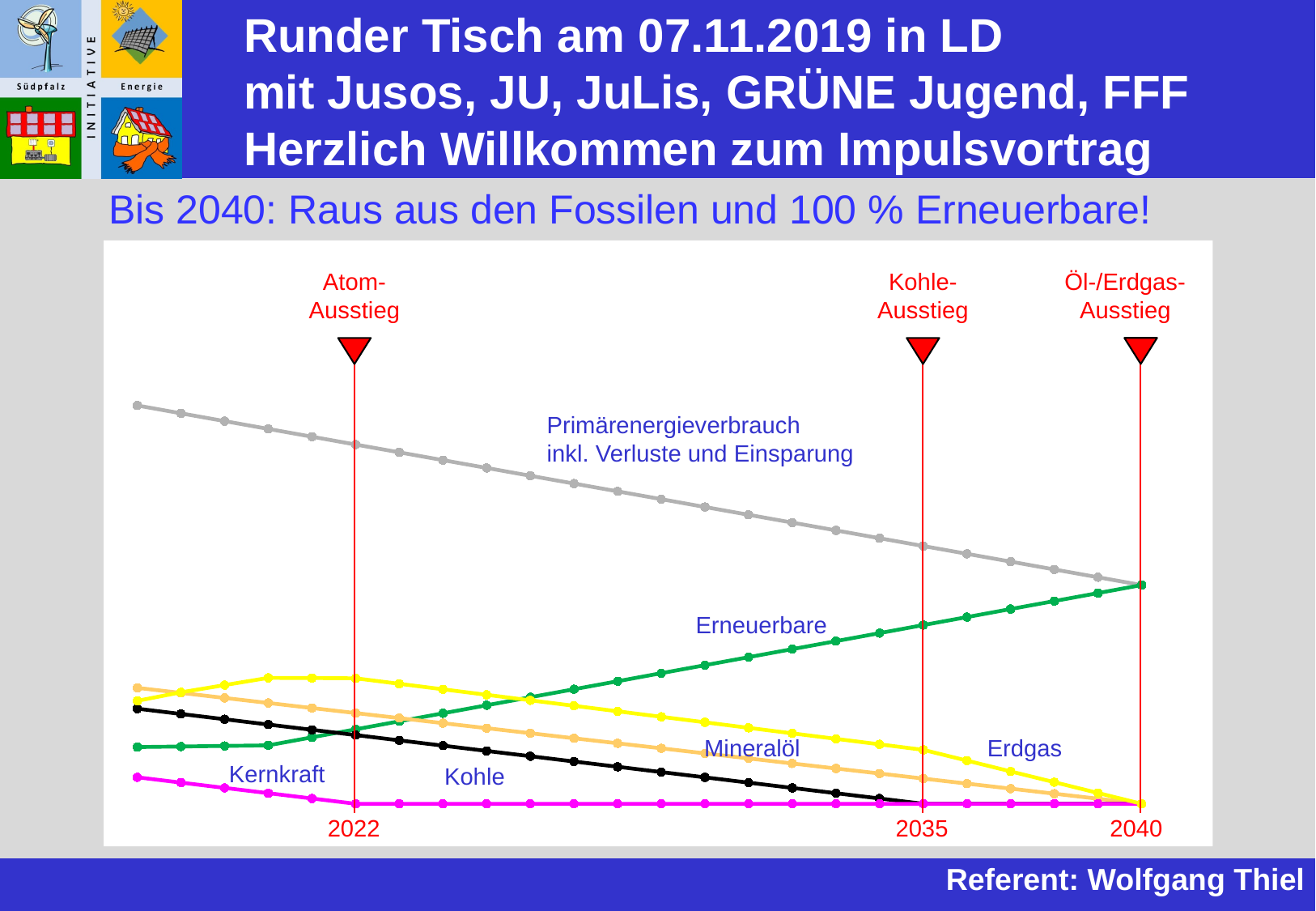
At 2022, which is larger: Erdgas or Kernkraft? Erdgas Which series is drawn in green? Erneuerbare Which series has the highest value at the left edge of the chart? Primärenergieverbrauch In which year does the chart mark the Atom-Ausstieg? 2022 How many energy series are labelled on the chart? 6 Does the Erneuerbare line rise or fall from left to right? rise Does the Primärenergieverbrauch line rise or fall from left to right? fall What kind of chart is shown on the slide? line chart In which year does the chart mark the Kohle-Ausstieg? 2035 Does the Kohle line rise or fall from left to right? fall At 2035, which is larger: Erneuerbare or Kohle? Erneuerbare Which series has the lowest value at the left edge of the chart? Kernkraft